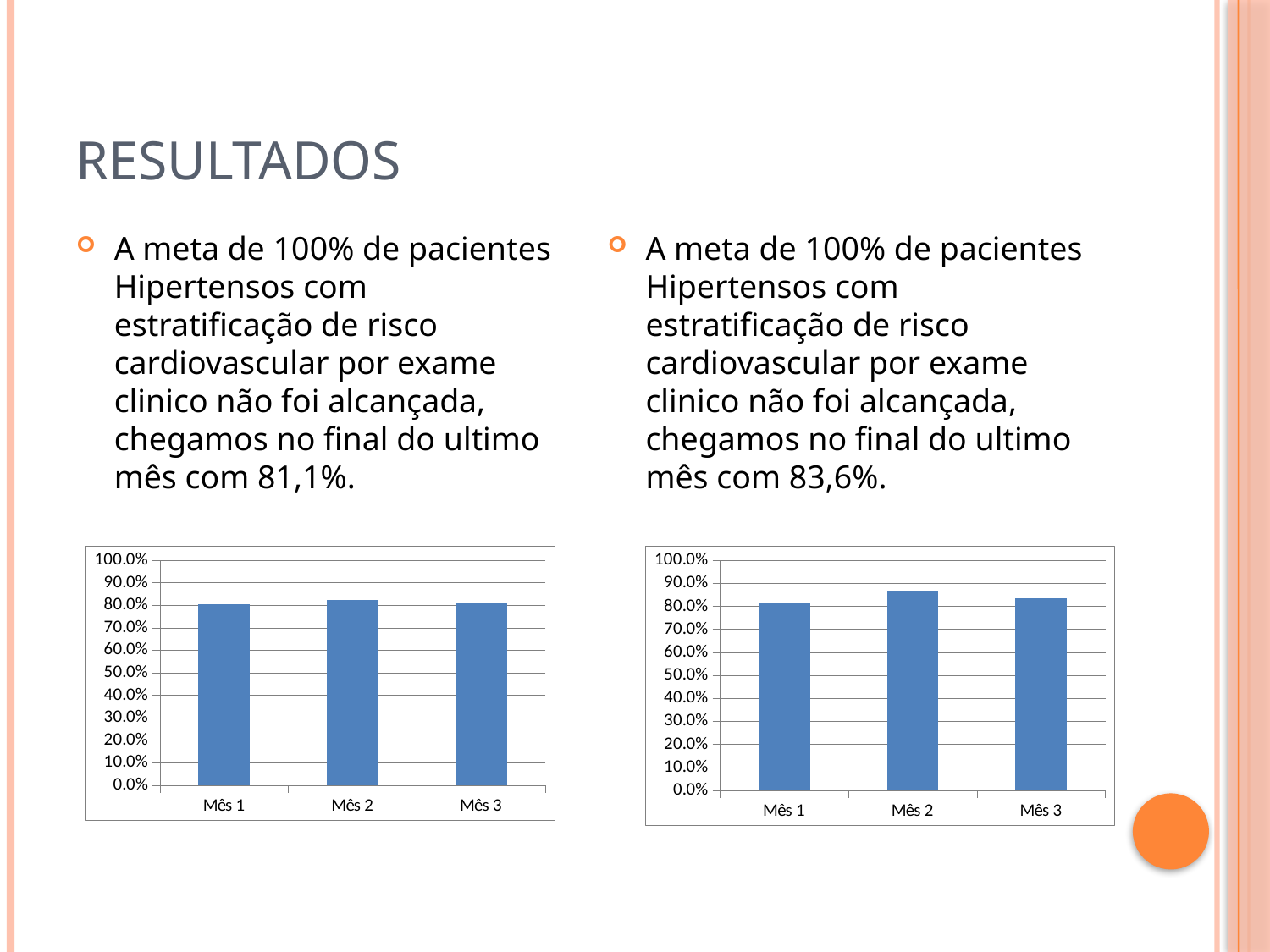
In the chart on the right side of the slide, is the value for Mês 2 greater or less than 80%? greater In the chart on the right side of the slide, which month has the lowest bar? Mês 1 In the chart on the right side of the slide, which month has the highest bar? Mês 2 In the chart on the right side of the slide, which is larger, the value for Mês 2 or the value for Mês 1? Mês 2 What kind of chart is the chart on the left side of the slide? bar chart How many bars are plotted in the chart on the left side of the slide? 3 In the chart on the left side of the slide, is the value for Mês 2 greater or less than 90%? less In the chart on the right side of the slide, is the value for Mês 3 greater or less than 90%? less What is the label of the first category on the x axis of the chart on the left side of the slide? Mês 1 How many categories are shown on the x axis of the chart on the right side of the slide? 3 What is the highest value shown on the y axis of the chart on the left side of the slide? 100.0%